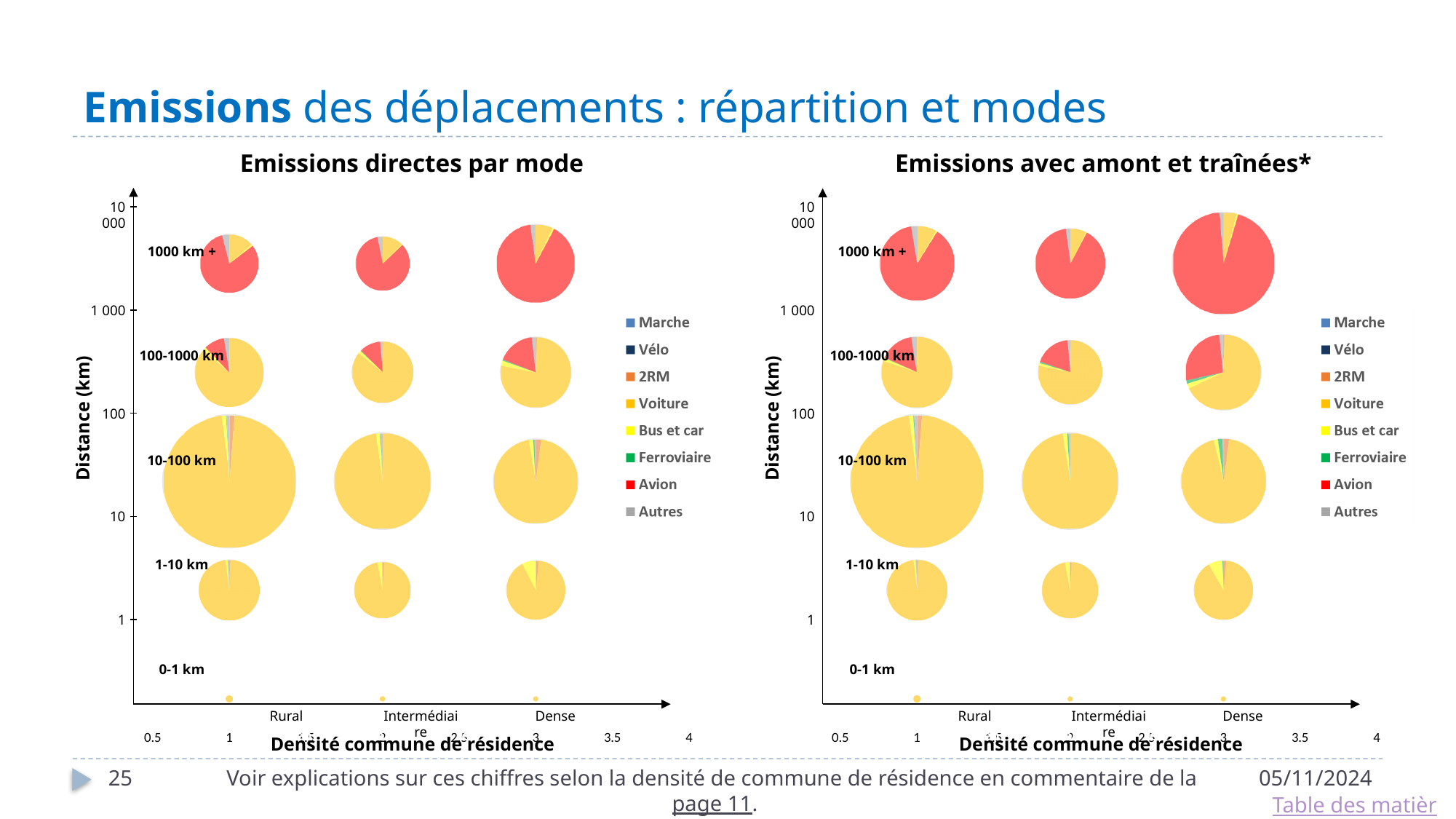
How many series does the legend of the right chart "Emissions avec amont et traînées*" list? 8 In the left chart "Emissions directes par mode", which distance band has the smallest pie for the Dense density? 0-1 km In the right chart "Emissions avec amont et traînées*", which mode makes up the largest share of the 10-100 km pies? Voiture In the left chart "Emissions directes par mode", how many density categories are shown on the x axis? 3 In the left chart "Emissions directes par mode", which distance band has the largest pie for the Rural density? 10-100 km In the right chart "Emissions avec amont et traînées*", is the 1000 km + pie larger for Dense or for Rural? Dense What is the title of the right chart on the slide? Emissions avec amont et traînées* What kind of chart is used in the left chart titled "Emissions directes par mode"? pie charts In the right chart "Emissions avec amont et traînées*", which density category has the largest pie in the 1000 km + band? Dense In the right chart "Emissions avec amont et traînées*", how many distance bands are labelled along the y axis? 5 How many series does the legend of the left chart "Emissions directes par mode" list? 8 In the left chart "Emissions directes par mode", which mode makes up the largest share of the 1000 km + pies? Avion